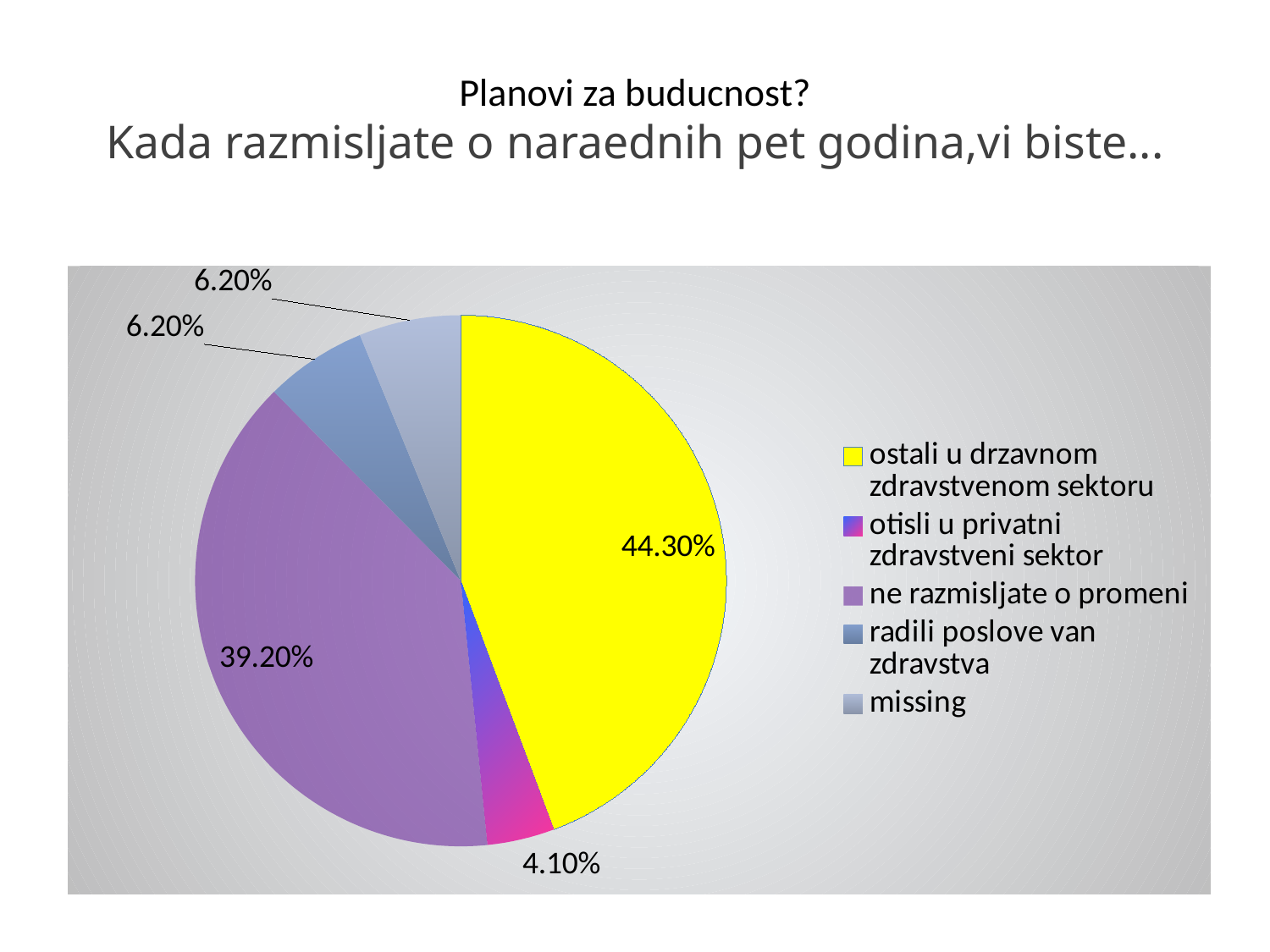
Which category has the smallest share of the pie? otisli u privatni zdravstveni sektor How many categories does the legend list? 5 What is the combined share of 'radili poslove van zdravstva' and 'missing'? 12.40% What colour is the slice for 'ostali u drzavnom zdravstvenom sektoru'? yellow What share of the pie is 'ne razmisljate o promeni'? 39.20% What is the difference between the shares for 'ostali u drzavnom zdravstvenom sektoru' and 'ne razmisljate o promeni'? 5.10% What share of the pie is 'missing'? 6.20% What share of the pie is 'ostali u drzavnom zdravstvenom sektoru'? 44.30% Which is larger: the share for 'radili poslove van zdravstva' or the share for 'otisli u privatni zdravstveni sektor'? radili poslove van zdravstva Which category has the largest share of the pie? ostali u drzavnom zdravstvenom sektoru What kind of chart is shown on the slide? pie chart